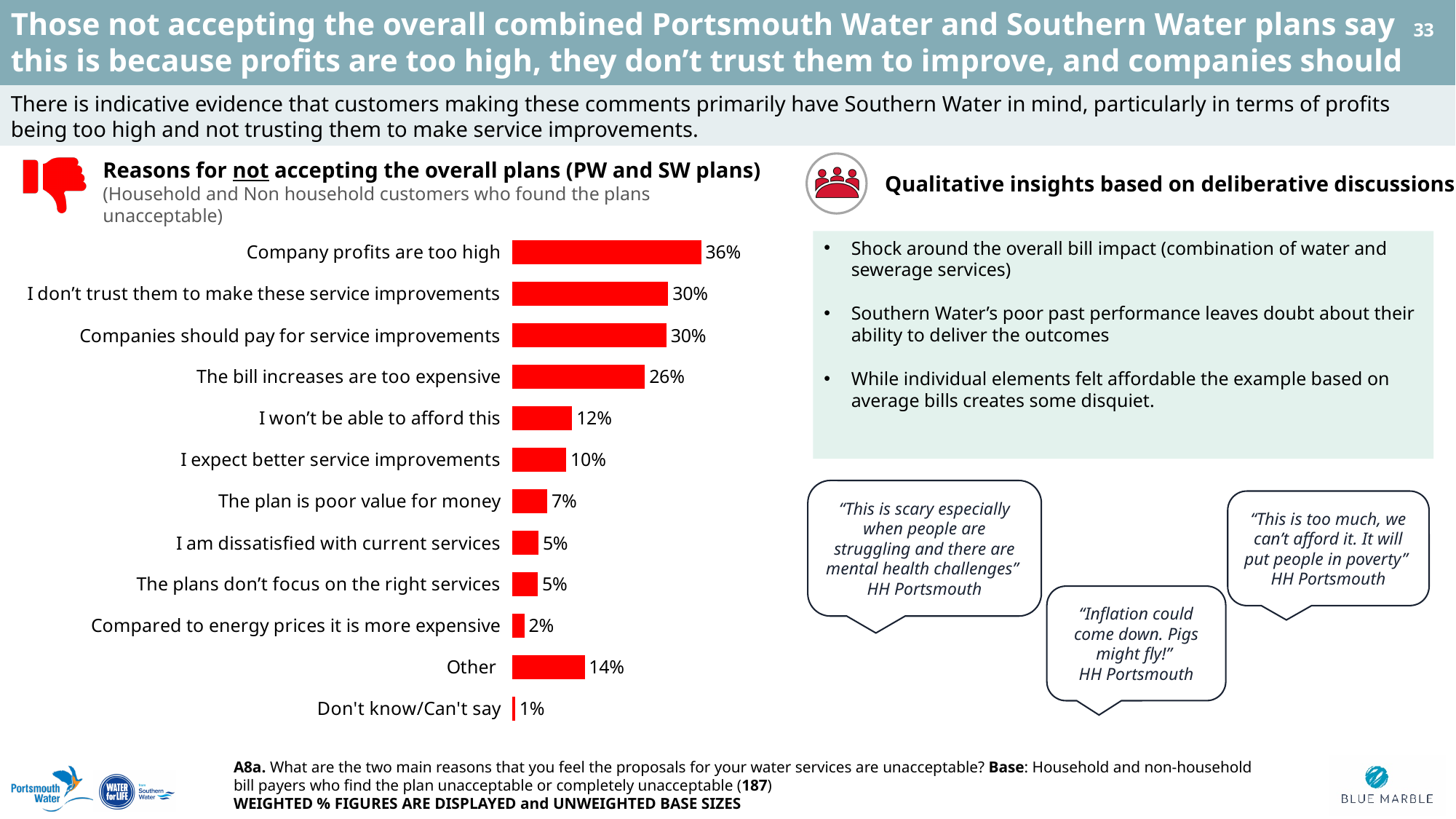
What is the difference between 'Company profits are too high' and 'I won't be able to afford this'? 24 percentage points Which category has the lowest value in the chart? Don't know/Can't say What percentage chose 'Other' as a reason for not accepting the plans? 14% How many reasons (categories) are listed in the bar chart? 12 Which reason has the highest percentage in the chart? Company profits are too high What colour are the bars in the chart? Red What is the value for 'The bill increases are too expensive'? 26% What is the combined value of 'I am dissatisfied with current services' and 'The plans don't focus on the right services'? 10% What value is shown for 'Compared to energy prices it is more expensive'? 2% What type of chart is used to show the reasons for not accepting the overall plans? Bar chart Which is larger: 'I expect better service improvements' or 'The plan is poor value for money'? I expect better service improvements What percentage of respondents said company profits are too high? 36%